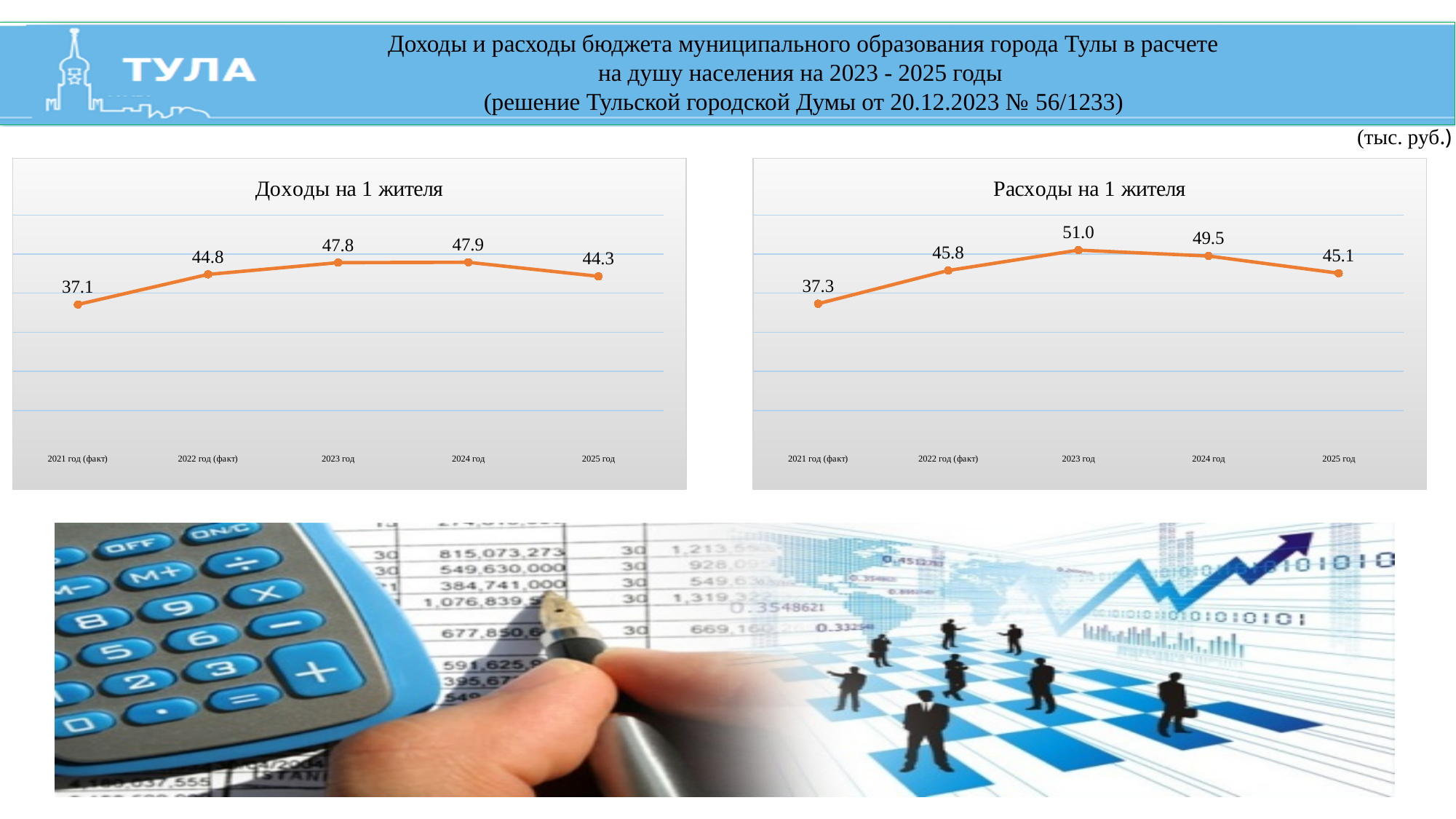
How many data points are plotted in the chart titled "Доходы на 1 жителя"? 5 What type of chart is the chart titled "Расходы на 1 жителя"? Line chart In the chart titled "Расходы на 1 жителя", which year has the highest value? 2023 год In the chart titled "Расходы на 1 жителя", what is the value for 2023 год? 51.0 In the chart titled "Расходы на 1 жителя", which is larger: the value for 2024 год or the value for 2025 год? 2024 год In the chart titled "Доходы на 1 жителя", what is the value for 2021 год (факт)? 37.1 In the chart titled "Доходы на 1 жителя", what is the value for 2025 год? 44.3 In the chart titled "Доходы на 1 жителя", which year has the lowest value? 2021 год (факт) In the chart titled "Расходы на 1 жителя", what is the value for 2022 год (факт)? 45.8 In the chart titled "Доходы на 1 жителя", do the values rise or fall from 2021 год (факт) to 2023 год? Rise In the chart titled "Расходы на 1 жителя", what is the difference between the values for 2023 год and 2025 год? 5.9 In the chart titled "Доходы на 1 жителя", what is the difference between the values for 2022 год (факт) and 2021 год (факт)? 7.7